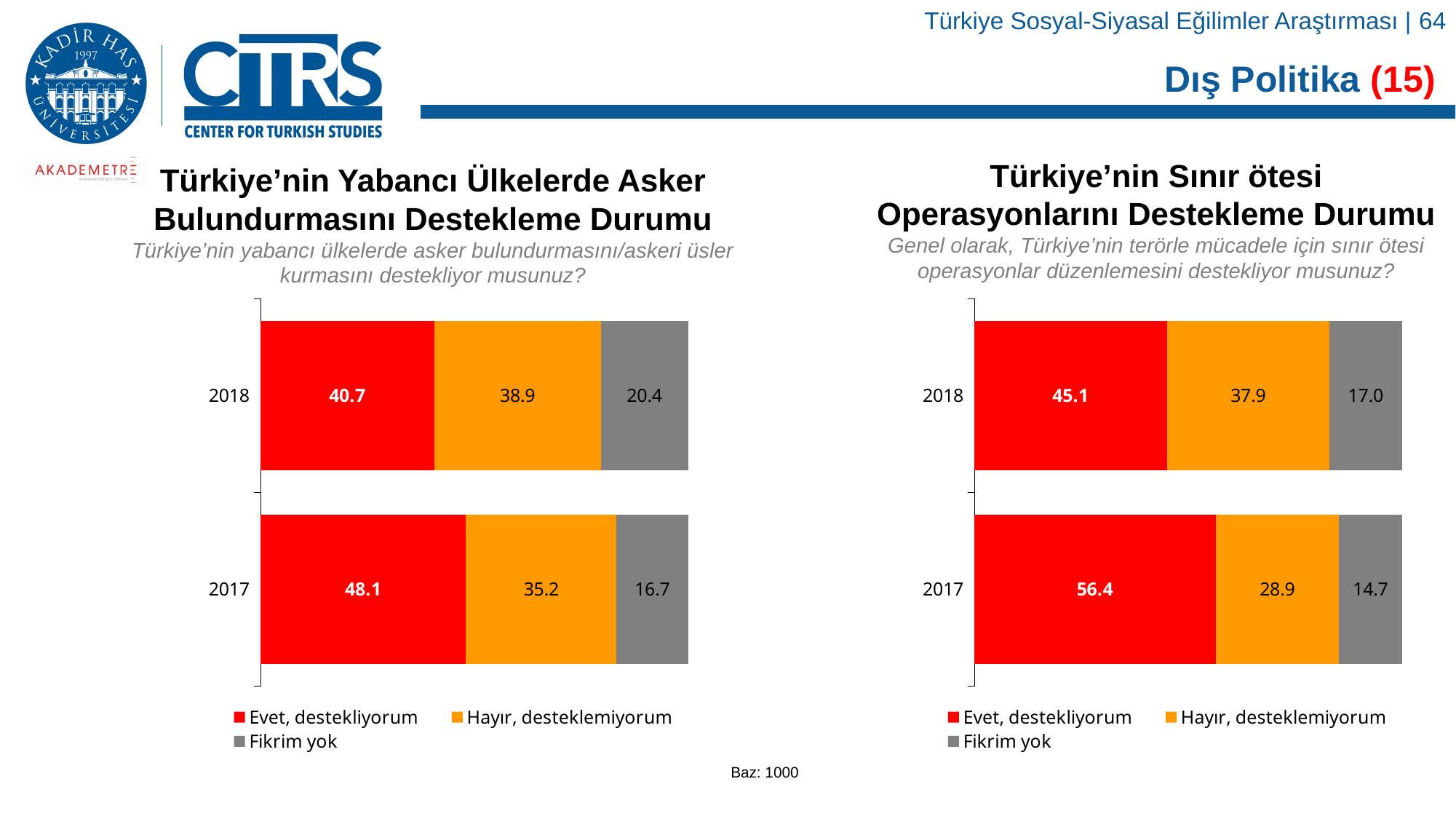
In the right chart (Türkiye'nin Sınır ötesi Operasyonlarını Destekleme Durumu), what is the value for 'Hayır, desteklemiyorum' in 2018? 37.9 In the left chart (Türkiye'nin Yabancı Ülkelerde Asker Bulundurmasını Destekleme Durumu), what is the difference between the 'Evet, destekliyorum' values for 2017 and 2018? 7.4 In the left chart (Türkiye'nin Yabancı Ülkelerde Asker Bulundurmasını Destekleme Durumu), what is the value for 'Fikrim yok' in 2017? 16.7 In the left chart (Türkiye'nin Yabancı Ülkelerde Asker Bulundurmasını Destekleme Durumu), which year has the higher 'Hayır, desteklemiyorum' value? 2018 In the right chart (Türkiye'nin Sınır ötesi Operasyonlarını Destekleme Durumu), which year has the higher 'Fikrim yok' value? 2018 How many series does the legend of the right chart (Türkiye'nin Sınır ötesi Operasyonlarını Destekleme Durumu) list? 3 How many years (categories) are shown in the right chart (Türkiye'nin Sınır ötesi Operasyonlarını Destekleme Durumu)? 2 In the left chart (Türkiye'nin Yabancı Ülkelerde Asker Bulundurmasını Destekleme Durumu), what is the total of the 2018 stacked bar? 100.0 In the right chart (Türkiye'nin Sınır ötesi Operasyonlarını Destekleme Durumu), what is the difference between the 'Evet, destekliyorum' values for 2017 and 2018? 11.3 What kind of chart is the left chart (Türkiye'nin Yabancı Ülkelerde Asker Bulundurmasını Destekleme Durumu)? Stacked bar chart In the right chart (Türkiye'nin Sınır ötesi Operasyonlarını Destekleme Durumu), what is the value for 'Evet, destekliyorum' in 2017? 56.4 In the left chart (Türkiye'nin Yabancı Ülkelerde Asker Bulundurmasını Destekleme Durumu), what is the value for 'Evet, destekliyorum' in 2018? 40.7